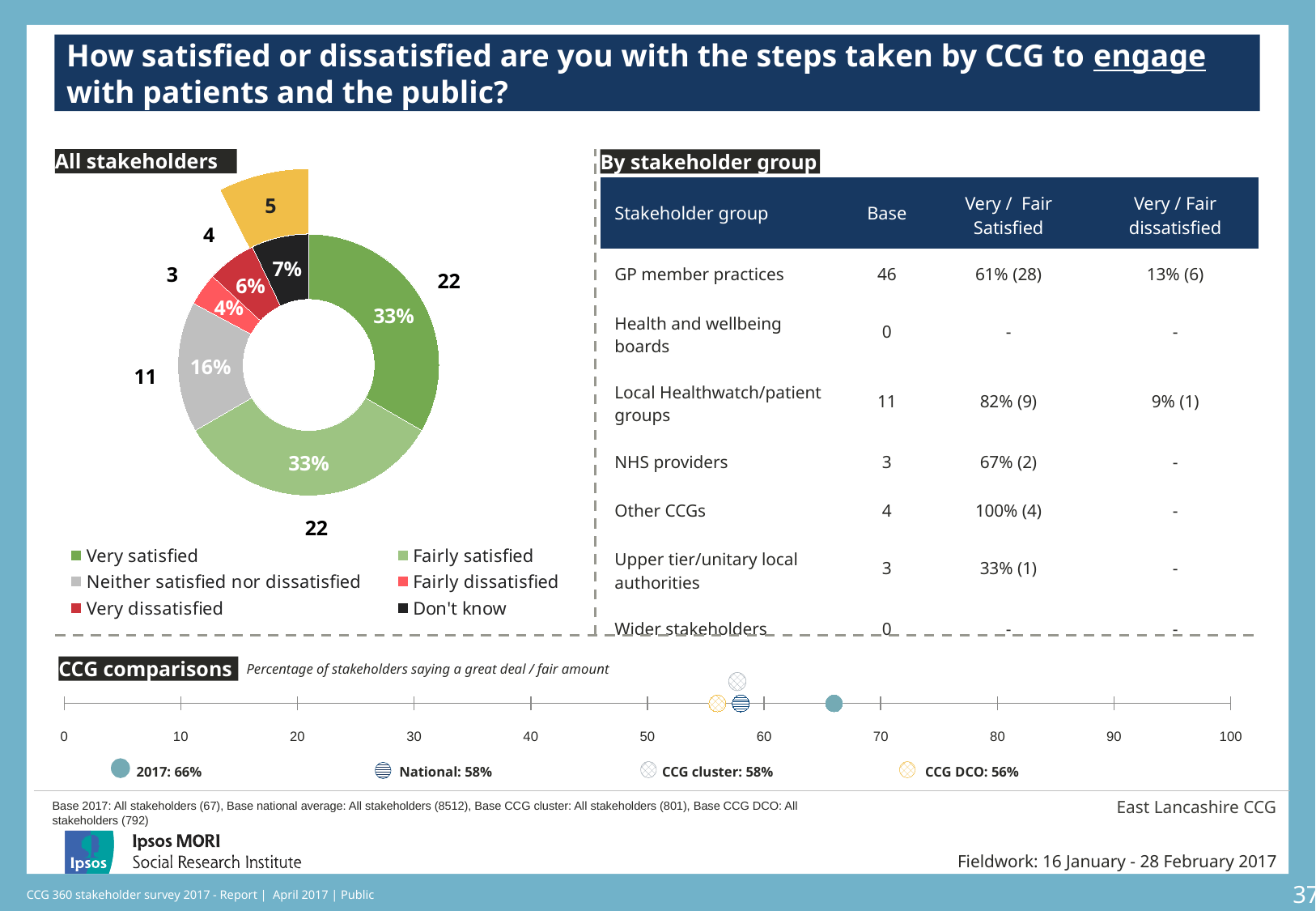
What type of chart is used for 'All stakeholders'? Donut (pie) chart In the 'CCG comparisons' chart, what is the CCG DCO value? 56% In the 'All stakeholders' donut chart, what percentage of stakeholders answered 'Don't know'? 7% In the 'All stakeholders' donut chart, which category has the smallest share? Fairly dissatisfied In the 'All stakeholders' donut chart, what percentage of stakeholders are very satisfied? 33% In the 'All stakeholders' donut chart, what is the difference in percentage points between 'Very dissatisfied' and 'Fairly dissatisfied'? 2 In the 'All stakeholders' donut chart, which is larger: the share for 'Neither satisfied nor dissatisfied' or the share for 'Don't know'? Neither satisfied nor dissatisfied How many categories does the legend of the 'All stakeholders' donut chart list? 6 In the 'CCG comparisons' chart, what is the 2017 value for this CCG? 66% In the 'All stakeholders' donut chart, what percentage of stakeholders are neither satisfied nor dissatisfied? 16% In the 'All stakeholders' donut chart, how many stakeholders are fairly dissatisfied? 3 In the 'CCG comparisons' chart, what is the difference between the 2017 value and the National value? 8 percentage points